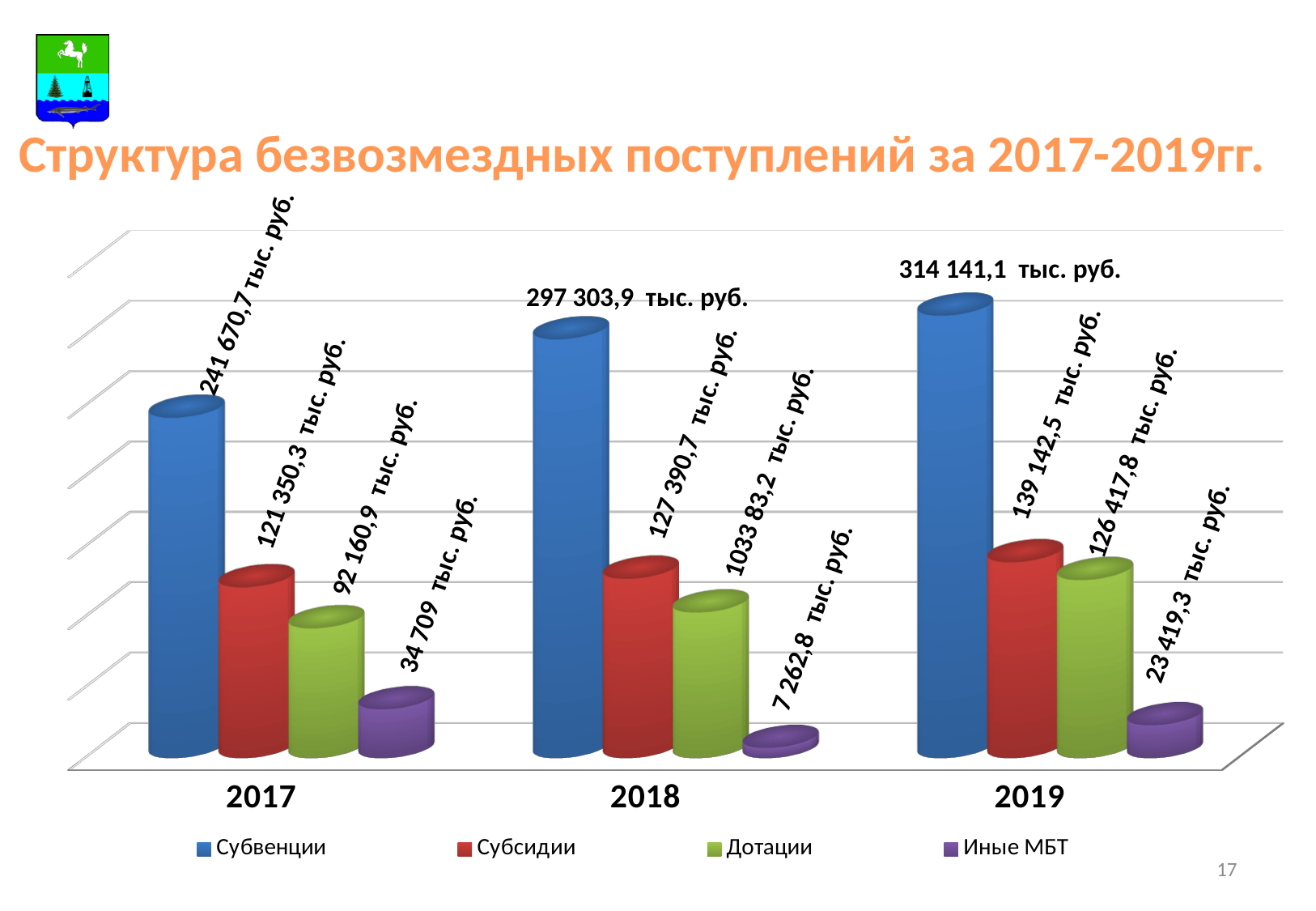
What is the difference between the Субвенции values for 2019 and 2018? 16 837,2 тыс. руб. What kind of chart is shown on the slide? Bar chart How many series does the legend list? 4 What is the value for Иные МБТ in 2018? 7 262,8 тыс. руб. Which is larger: Субсидии in 2019 or Дотации in 2019? Субсидии in 2019 How many years are shown on the x axis? 3 What is the value for Дотации in 2019? 126 417,8 тыс. руб. Do the values for Субвенции rise or fall from 2017 to 2019? Rise What is the value for Субсидии in 2017? 121 350,3 тыс. руб. In which year is the value for Субвенции the highest? 2019 In which year is the value for Иные МБТ the lowest? 2018 What is the value for Субвенции in 2019? 314 141,1 тыс. руб.